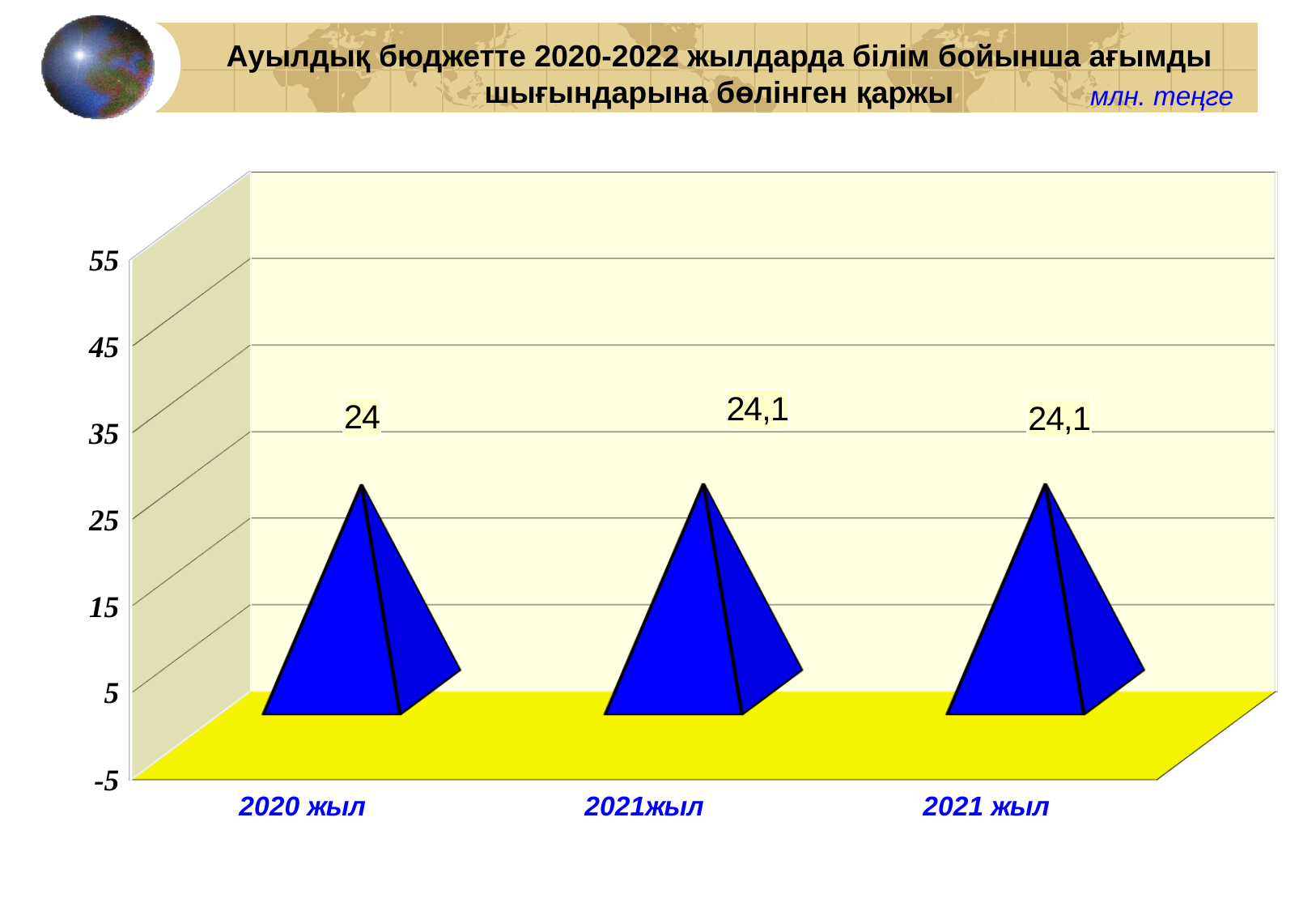
What value is shown for 2020 жыл? 24 What value is shown for the rightmost bar? 24,1 What colour are the bars in the chart? blue What value is shown for the middle bar (2021жыл)? 24,1 Which category has the lowest value? 2020 жыл What kind of chart is shown on the slide? bar chart How many categories are shown on the x axis? 3 Which is larger: the value for 2020 жыл or the value for the middle bar (2021жыл)? the middle bar (2021жыл) What is the difference between the value for the middle bar and the value for 2020 жыл? 0,1 What unit of measurement is indicated in the top right of the slide? млн. теңге Is the value for 2020 жыл greater or less than 25? less Is the value for the rightmost bar greater or less than 15? greater